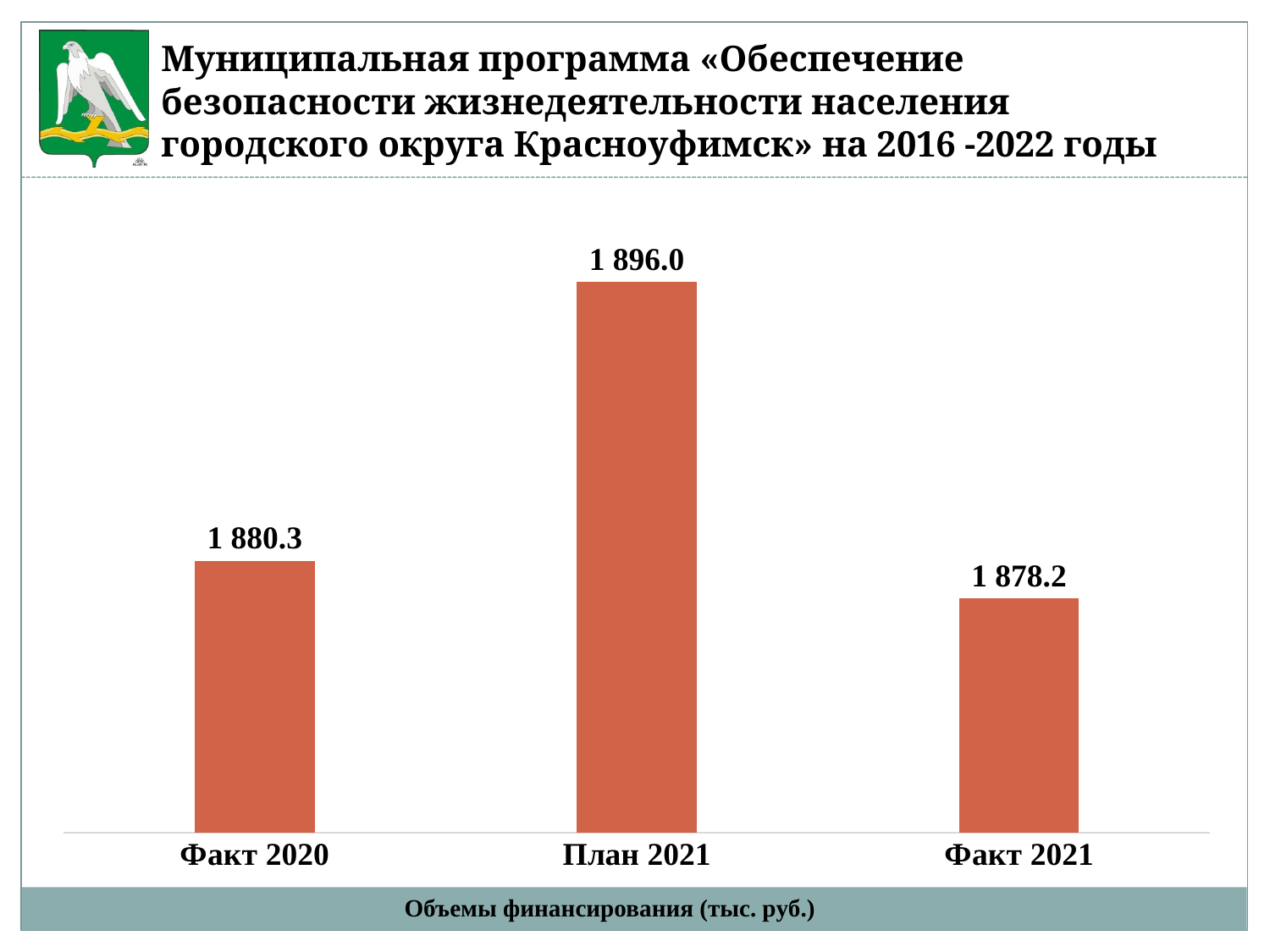
What is the difference between the values for План 2021 and Факт 2020? 15.7 What is the value for Факт 2020? 1 880.3 Which is larger, the value for Факт 2020 or the value for Факт 2021? Факт 2020 How many categories are shown in the chart? 3 What kind of chart is shown on the slide? Bar chart What is the difference between the values for Факт 2020 and Факт 2021? 2.1 What unit of measurement is stated in the chart caption? тыс. руб. Which category has the lowest value? Факт 2021 Which category has the highest value? План 2021 What is the value for План 2021? 1 896.0 What is the difference between the values for План 2021 and Факт 2021? 17.8 What is the value for Факт 2021? 1 878.2